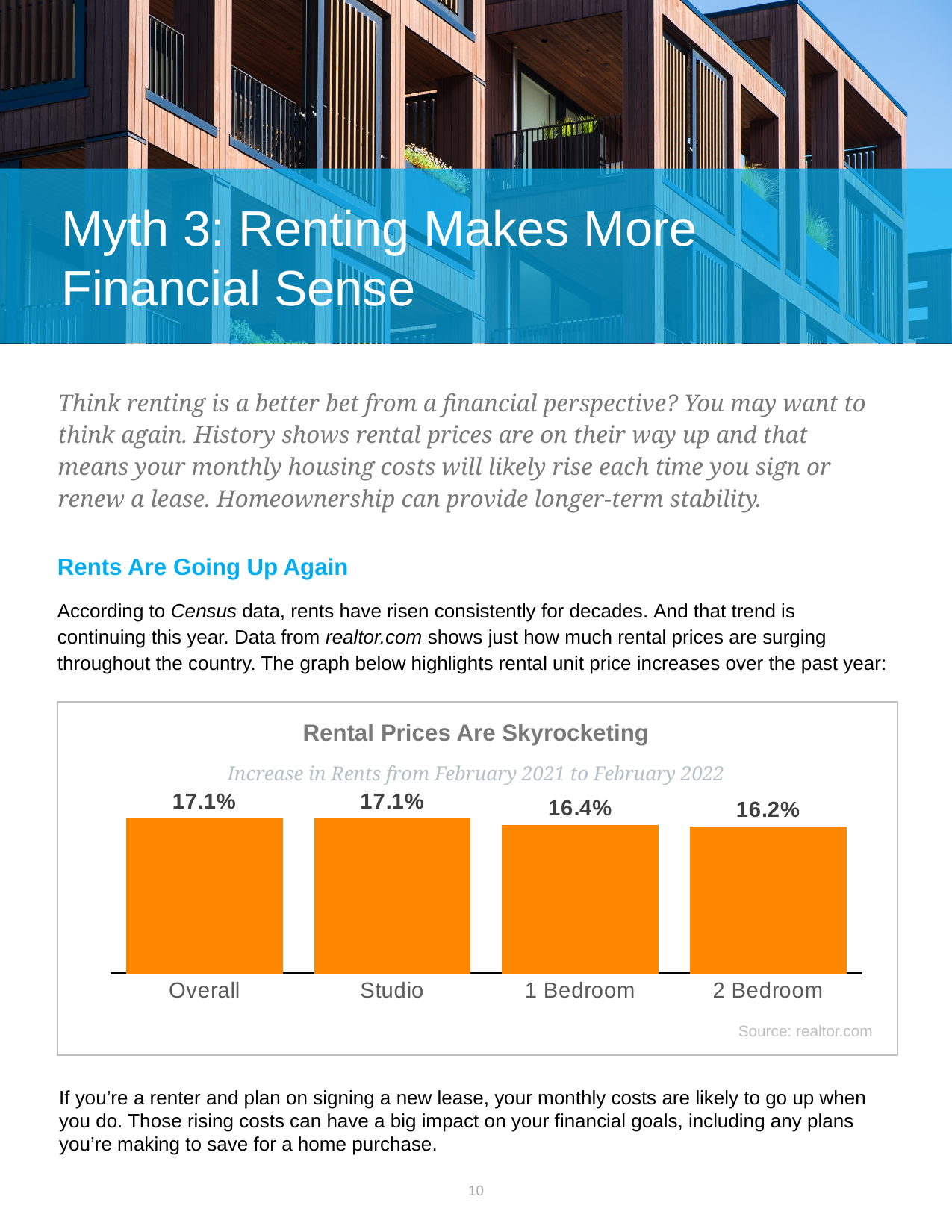
Which category has the lowest value in the Rental Prices Are Skyrocketing chart? 2 Bedroom What is the value for Studio in the Rental Prices Are Skyrocketing chart? 17.1% Do the values in the Rental Prices Are Skyrocketing chart rise or fall from left to right? Fall What kind of chart is the Rental Prices Are Skyrocketing chart? Bar chart What is the value for 2 Bedroom in the Rental Prices Are Skyrocketing chart? 16.2% What is the difference between the Studio value and the 1 Bedroom value in the Rental Prices Are Skyrocketing chart? 0.7 percentage points What is the difference between the Overall value and the 2 Bedroom value in the Rental Prices Are Skyrocketing chart? 0.9 percentage points How many categories are shown in the Rental Prices Are Skyrocketing chart? 4 What is the value for 1 Bedroom in the Rental Prices Are Skyrocketing chart? 16.4% What is the subtitle of the Rental Prices Are Skyrocketing chart? Increase in Rents from February 2021 to February 2022 Which is larger in the Rental Prices Are Skyrocketing chart, the value for 1 Bedroom or the value for 2 Bedroom? 1 Bedroom What is the value for Overall in the Rental Prices Are Skyrocketing chart? 17.1%